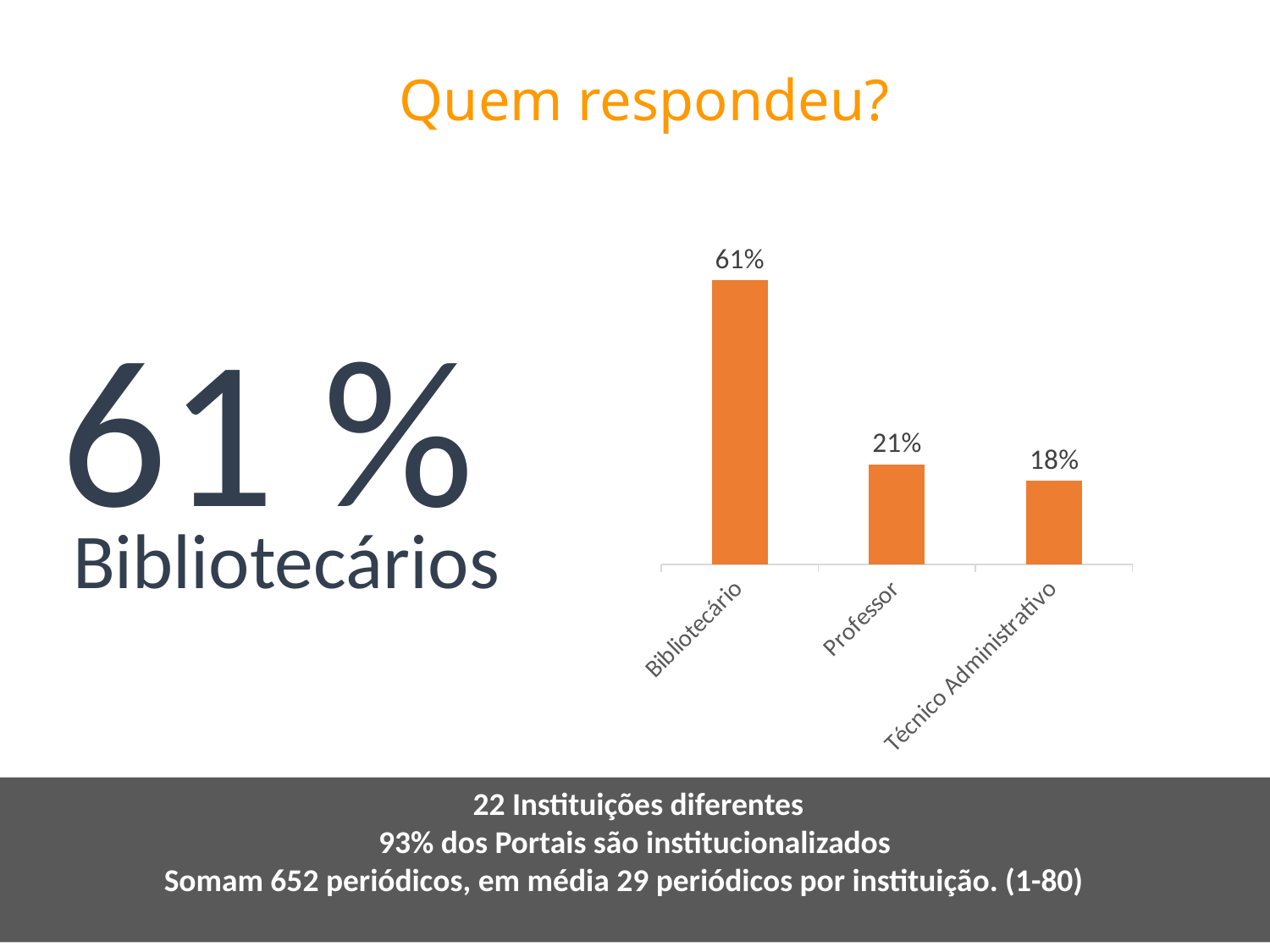
Which category has the lowest value? Técnico Administrativo Do the values rise or fall from left to right across the categories? fall What is the difference between the values for Professor and Técnico Administrativo? 3% What is the difference between the values for Bibliotecário and Professor? 40% What kind of chart is shown on the slide? bar chart How many categories are shown in the chart? 3 Which category has the highest value? Bibliotecário Which is larger, the value for Bibliotecário or the value for Técnico Administrativo? Bibliotecário What is the value for Técnico Administrativo? 18% What colour are the bars in the chart? orange What is the value for Professor? 21% What is the value for Bibliotecário? 61%